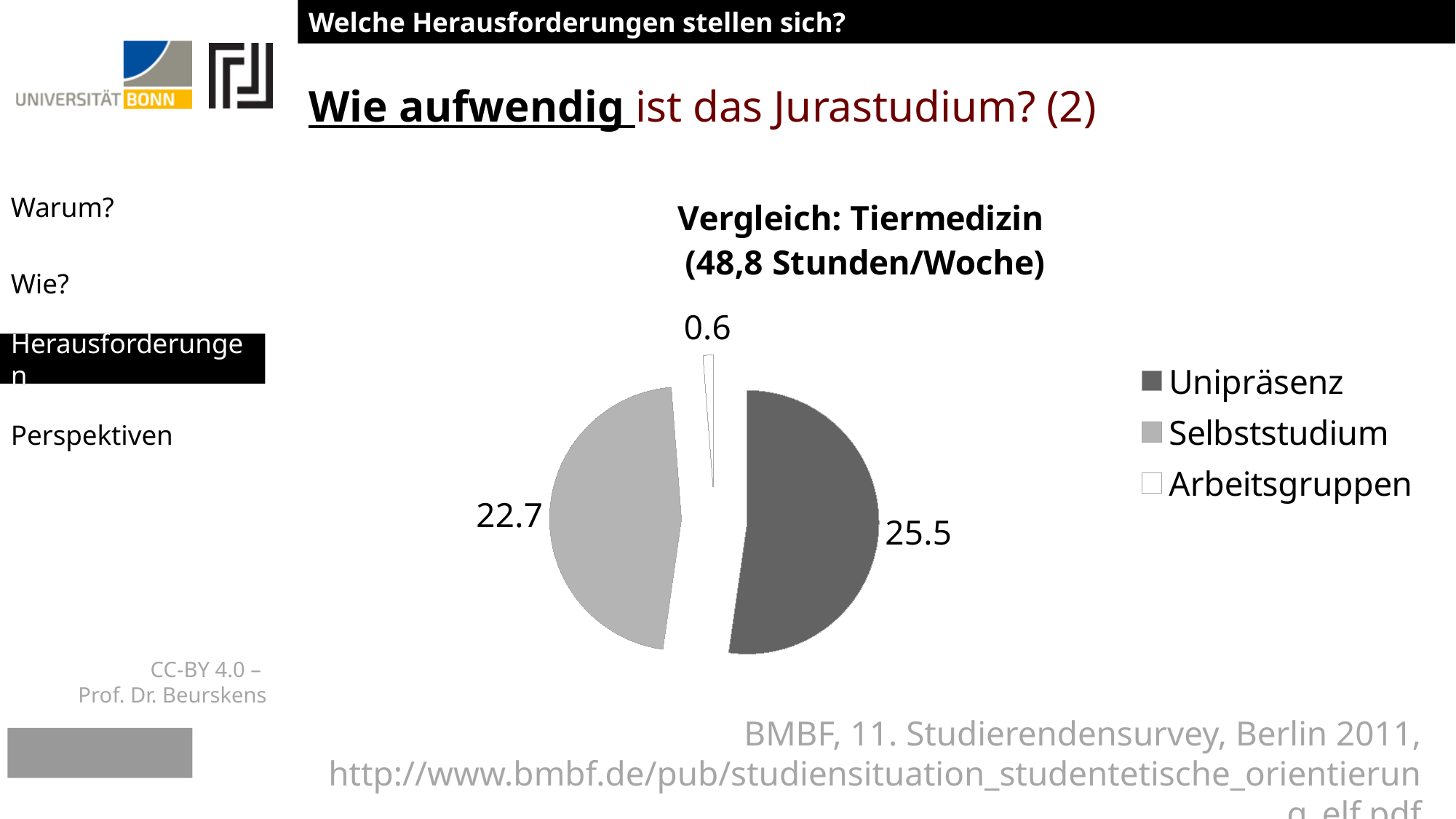
What is the difference between the values for Unipräsenz and Selbststudium? 2.8 What is the value for Unipräsenz in the pie chart? 25.5 Which legend entry is shown in the darkest colour? Unipräsenz How many slices does the pie chart have? 3 What is the title of the pie chart? Vergleich: Tiermedizin (48,8 Stunden/Woche) Which category has the largest slice in the pie chart? Unipräsenz What is the difference between the values for Selbststudium and Arbeitsgruppen? 22.1 Which is larger, the value for Selbststudium or the value for Arbeitsgruppen? Selbststudium Which category has the smallest slice in the pie chart? Arbeitsgruppen What kind of chart is shown on the slide? pie chart What is the value for Arbeitsgruppen in the pie chart? 0.6 What is the value for Selbststudium in the pie chart? 22.7